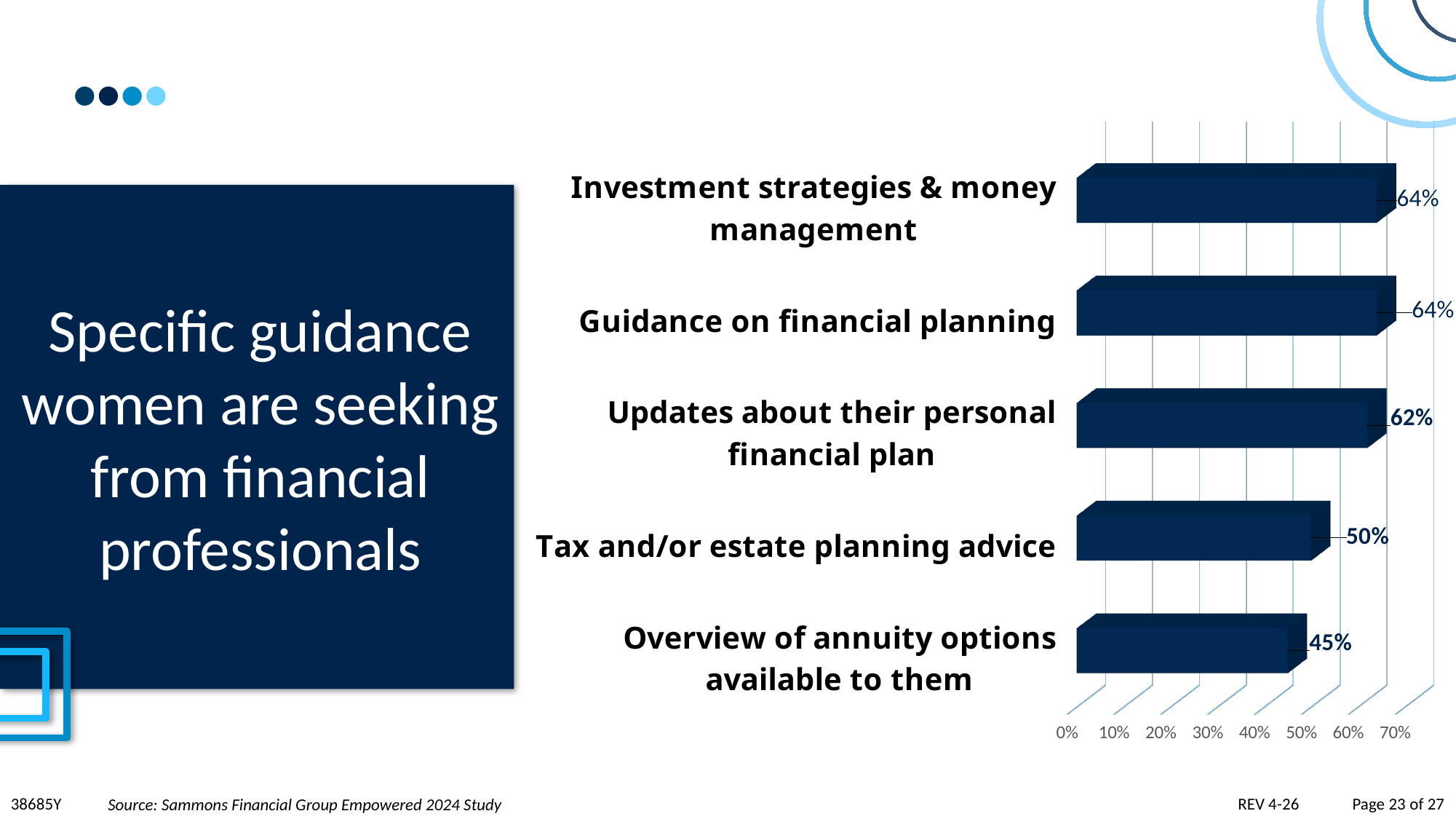
How many categories are shown on the chart? 5 Which category has the lowest value on the chart? Overview of annuity options available to them Is the value for 'Updates about their personal financial plan' greater or less than 60%? greater What is the value for 'Tax and/or estate planning advice'? 50% What percentage of women are seeking guidance on financial planning from financial professionals? 64% What is the difference between 'Updates about their personal financial plan' and 'Tax and/or estate planning advice'? 12% What is the difference between the value for 'Investment strategies & money management' and the value for 'Overview of annuity options available to them'? 19% What is the value for 'Overview of annuity options available to them'? 45% What is the highest value shown on the horizontal axis of the chart? 70% Which is larger: the value for 'Tax and/or estate planning advice' or the value for 'Overview of annuity options available to them'? Tax and/or estate planning advice What is the value for 'Updates about their personal financial plan'? 62% What kind of chart is shown on the slide? Bar chart